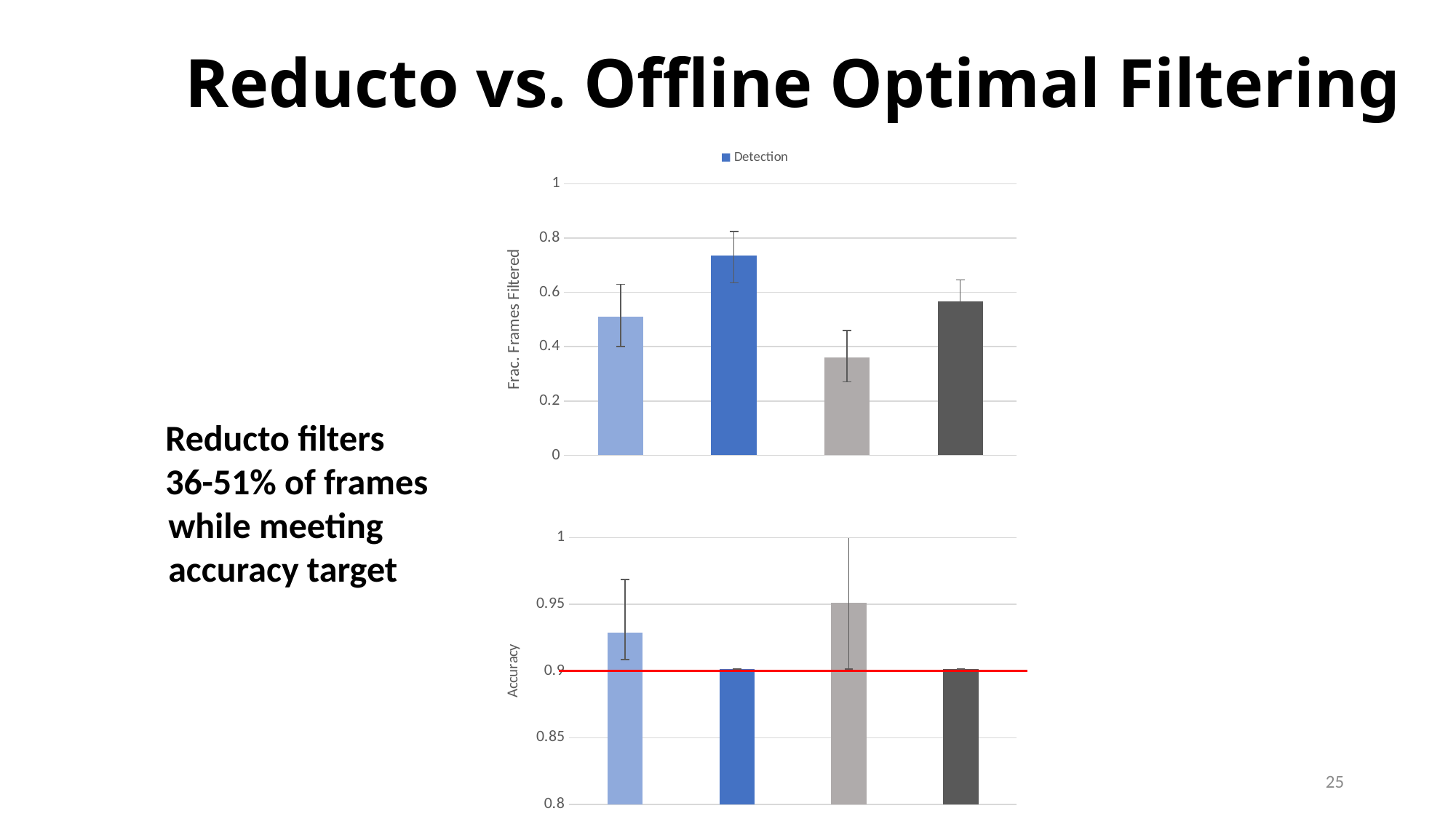
In the bottom chart (Accuracy), which bar is the highest? the third bar from the left (grey) What kind of chart is the top chart (Frac. Frames Filtered)? bar chart In the top chart (Frac. Frames Filtered), which bar is the highest? the second bar from the left (dark blue) In the top chart (Frac. Frames Filtered), is the value of the grey bar greater or less than 0.4? less How many series does the legend of the top chart (Frac. Frames Filtered) list? 1 In the top chart (Frac. Frames Filtered), which bar is the lowest? the third bar from the left (grey) In the top chart (Frac. Frames Filtered), is the value of the light blue bar greater or less than 0.4? greater In the top chart (Frac. Frames Filtered), is the value of the dark blue bar greater or less than 0.6? greater In the bottom chart (Accuracy), at what y-axis value is the red horizontal line drawn? 0.9 What is the y-axis label of the top chart? Frac. Frames Filtered How many bars are plotted in the bottom chart (Accuracy)? 4 How many bars are plotted in the top chart (Frac. Frames Filtered)? 4